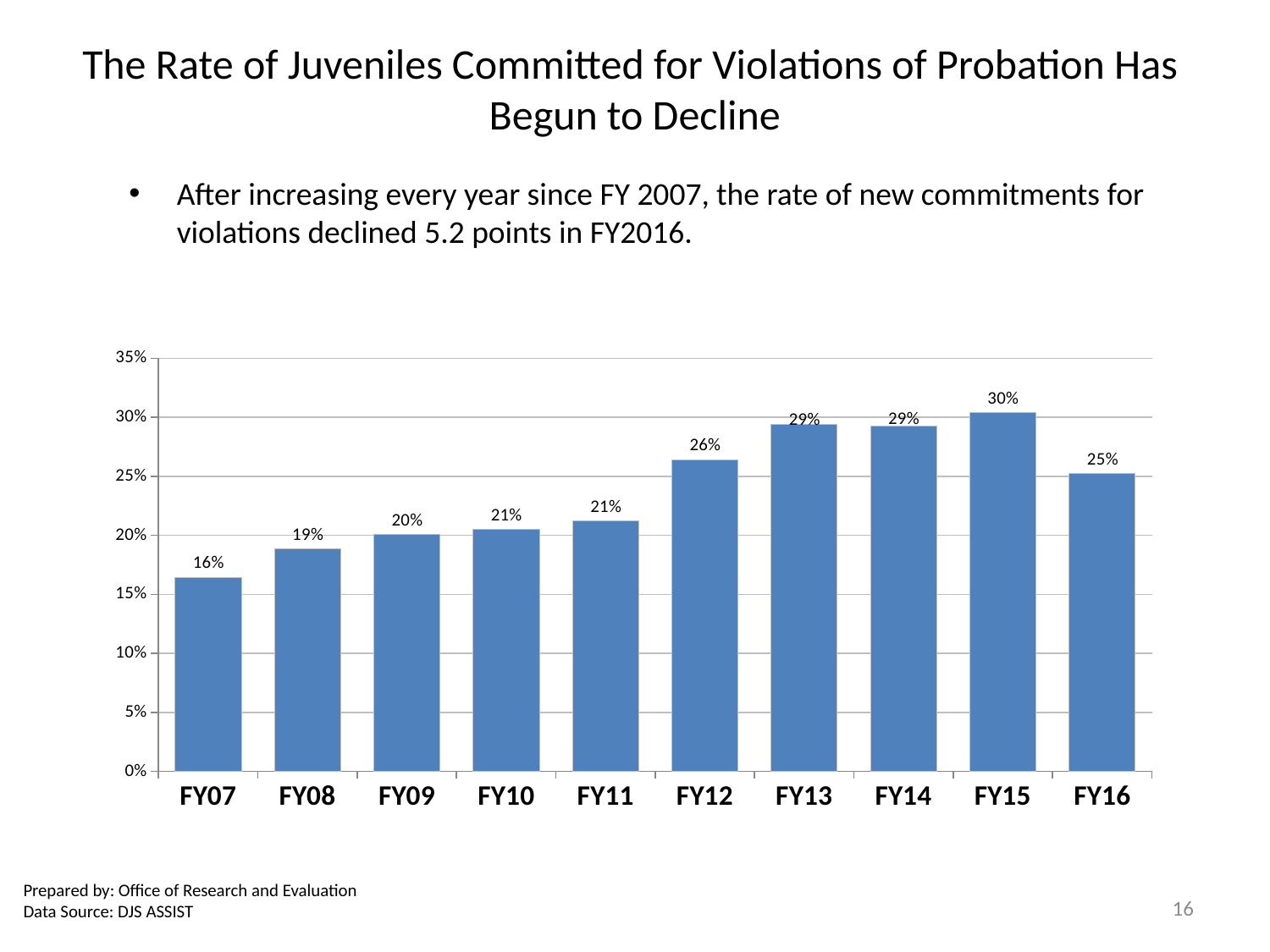
What kind of chart is shown on the slide? Bar chart Which fiscal year has the lowest value? FY07 What is the value for FY12? 26% Do the values generally rise or fall from FY07 to FY15? Rise How many fiscal years are shown on the x axis? 10 What is the value for FY07? 16% Is the value for FY12 greater or less than 25%? greater What is the value for FY16? 25% Which fiscal year has the highest value? FY15 What is the difference between the values for FY12 and FY07? 10 percentage points Is the value for FY07 greater or less than 20%? less Which is larger, the value for FY08 or the value for FY16? FY16